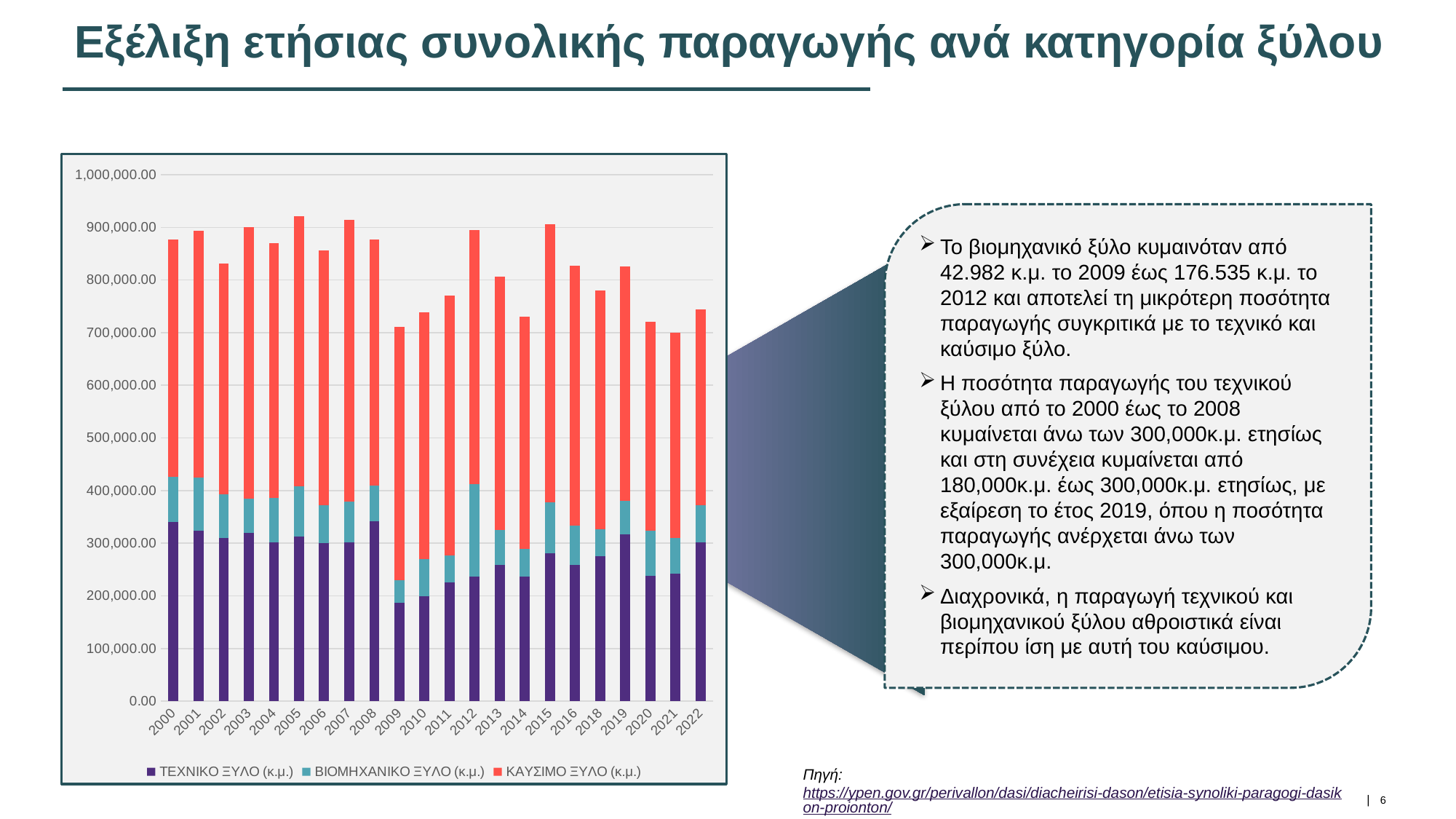
What is the title of the slide containing the chart? Εξέλιξη ετήσιας συνολικής παραγωγής ανά κατηγορία ξύλου Which year has the larger total stacked value, 2000 or 2009? 2000 Is the value of ΤΕΧΝΙΚΟ ΞΥΛΟ (κ.μ.) for 2009 greater or less than 200,000.00? less Is the value of ΤΕΧΝΙΚΟ ΞΥΛΟ (κ.μ.) for 2000 greater or less than 300,000.00? greater What kind of chart is shown on the slide? Stacked bar chart Is the total stacked value for 2005 greater or less than 900,000.00? greater Which year has the larger ΤΕΧΝΙΚΟ ΞΥΛΟ (κ.μ.) value, 2008 or 2010? 2008 How many years are shown on the x axis of the chart? 22 How many series does the chart legend list? 3 Does the total stacked value rise or fall from 2008 to 2009? fall Which series is shown in red in the chart? ΚΑΥΣΙΜΟ ΞΥΛΟ (κ.μ.)